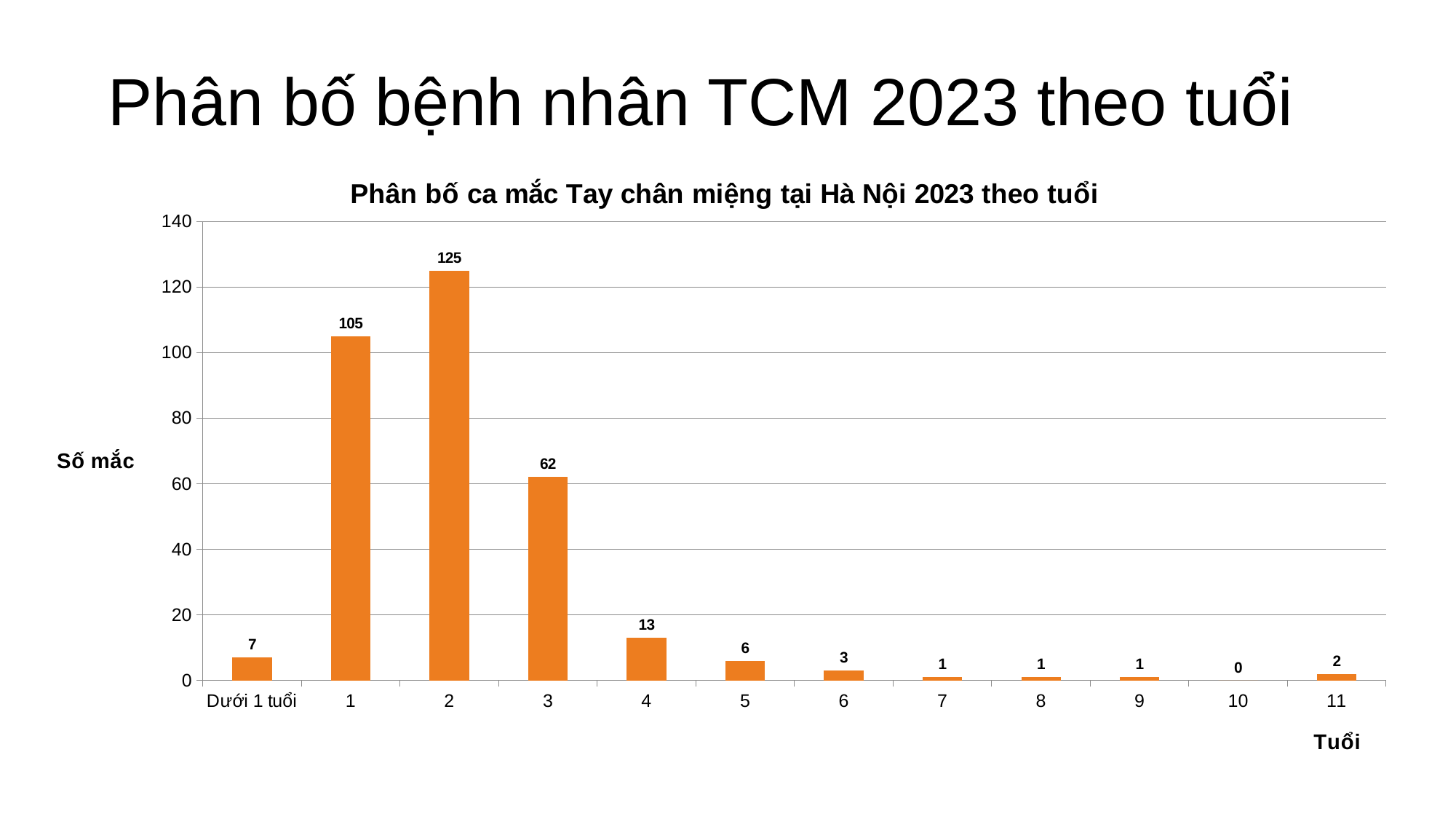
What is the number of cases for age 4? 13 What is the number of cases for age 2? 125 Which age category has the lowest number of cases? 10 What kind of chart is shown on the slide? Bar chart What is the title of the chart? Phân bố ca mắc Tay chân miệng tại Hà Nội 2023 theo tuổi What is the difference between the number of cases for age 3 and age 4? 49 How many age categories are shown on the x axis? 12 Which has more cases, age 1 or age 3? 1 What is the difference between the number of cases for age 2 and age 1? 20 What is the number of cases for the 'Dưới 1 tuổi' category? 7 Which age category has the highest number of cases? 2